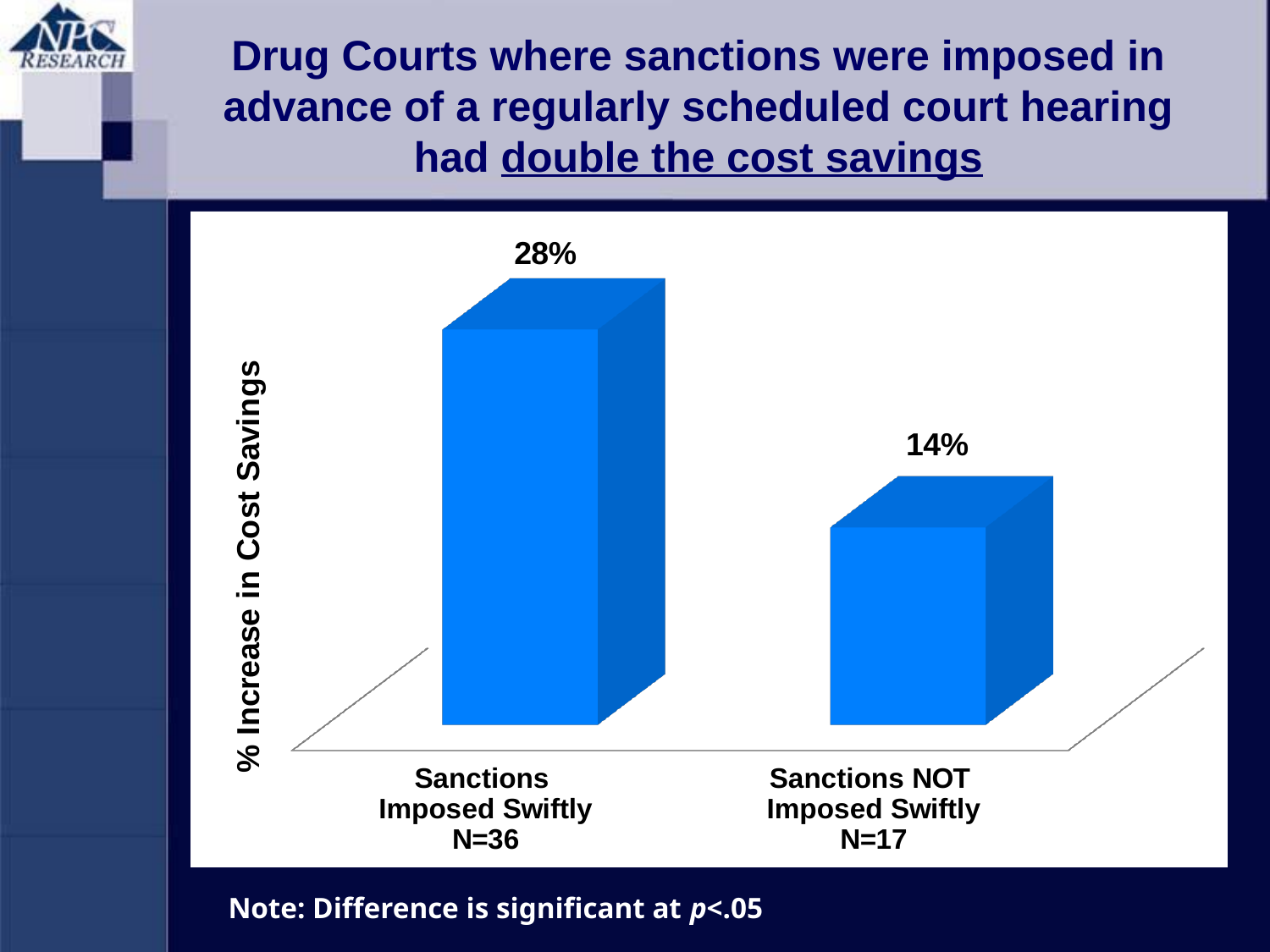
What is the % increase in cost savings for drug courts where sanctions were NOT imposed swiftly? 14% Which category has the higher % increase in cost savings? Sanctions Imposed Swiftly What is the sample size (N) for the Sanctions Imposed Swiftly group? N=36 What is the sample size (N) for the Sanctions NOT Imposed Swiftly group? N=17 Which category has the lower % increase in cost savings? Sanctions NOT Imposed Swiftly What is the % increase in cost savings for drug courts where sanctions were imposed swiftly? 28% According to the note below the chart, at what level is the difference significant? p<.05 How many categories are shown in the chart? 2 Is the % increase in cost savings larger for Sanctions Imposed Swiftly or for Sanctions NOT Imposed Swiftly? Sanctions Imposed Swiftly What kind of chart is shown on the slide? Bar chart What is the difference in % increase in cost savings between the Sanctions Imposed Swiftly and Sanctions NOT Imposed Swiftly groups? 14% What is the label on the vertical axis of the chart? % Increase in Cost Savings